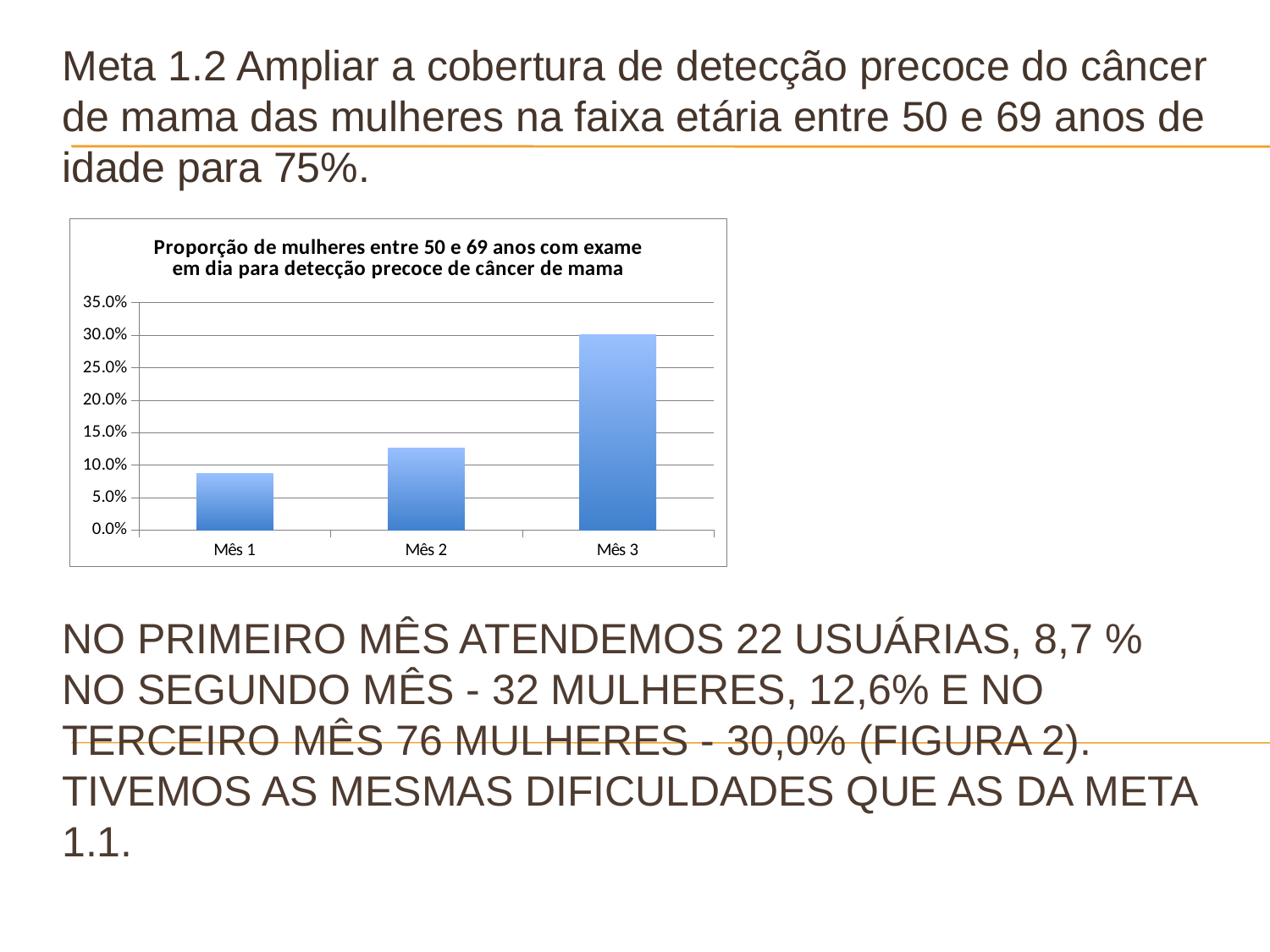
Which month has the highest value in the chart? Mês 3 Is the value for Mês 1 greater or less than 10.0%? less Is the value for Mês 2 greater or less than 15.0%? less Which is larger, the value for Mês 2 or the value for Mês 3? Mês 3 Is the value for Mês 3 greater or less than 25.0%? greater How many categories (months) are plotted on the x axis of the chart? 3 What kind of chart is shown on the slide? bar chart Which month has the lowest value in the chart? Mês 1 What is the title of the chart? Proporção de mulheres entre 50 e 69 anos com exame em dia para detecção precoce de câncer de mama Do the values rise or fall from Mês 1 to Mês 3? rise